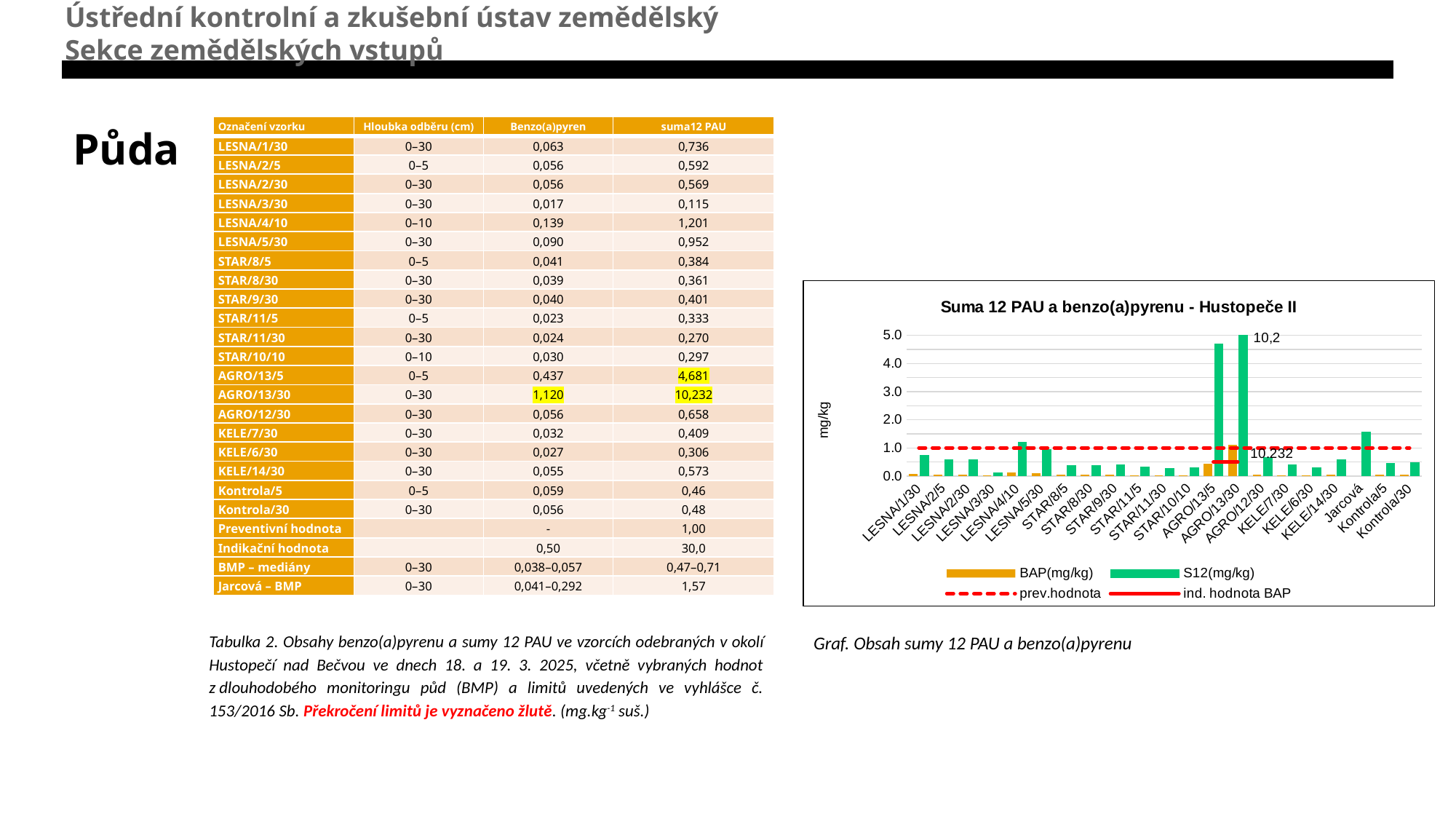
Which category has the highest BAP(mg/kg) bar in the chart? AGRO/13/30 Is the S12(mg/kg) value for LESNA/3/30 greater or less than 0.5? less Is the S12(mg/kg) value for LESNA/4/10 greater or less than 1.0? greater Is the S12(mg/kg) value for Jarcová greater or less than 1.0? greater What is the title of the chart? Suma 12 PAU a benzo(a)pyrenu - Hustopeče II Which has the larger S12(mg/kg) bar, LESNA/1/30 or STAR/11/30? LESNA/1/30 How many entries does the chart legend list? 4 What kind of chart is shown on the slide? combination bar and line chart Which category has the highest S12(mg/kg) bar in the chart? AGRO/13/30 How many sample categories are shown on the x axis of the chart? 21 What is the label on the y axis of the chart? mg/kg